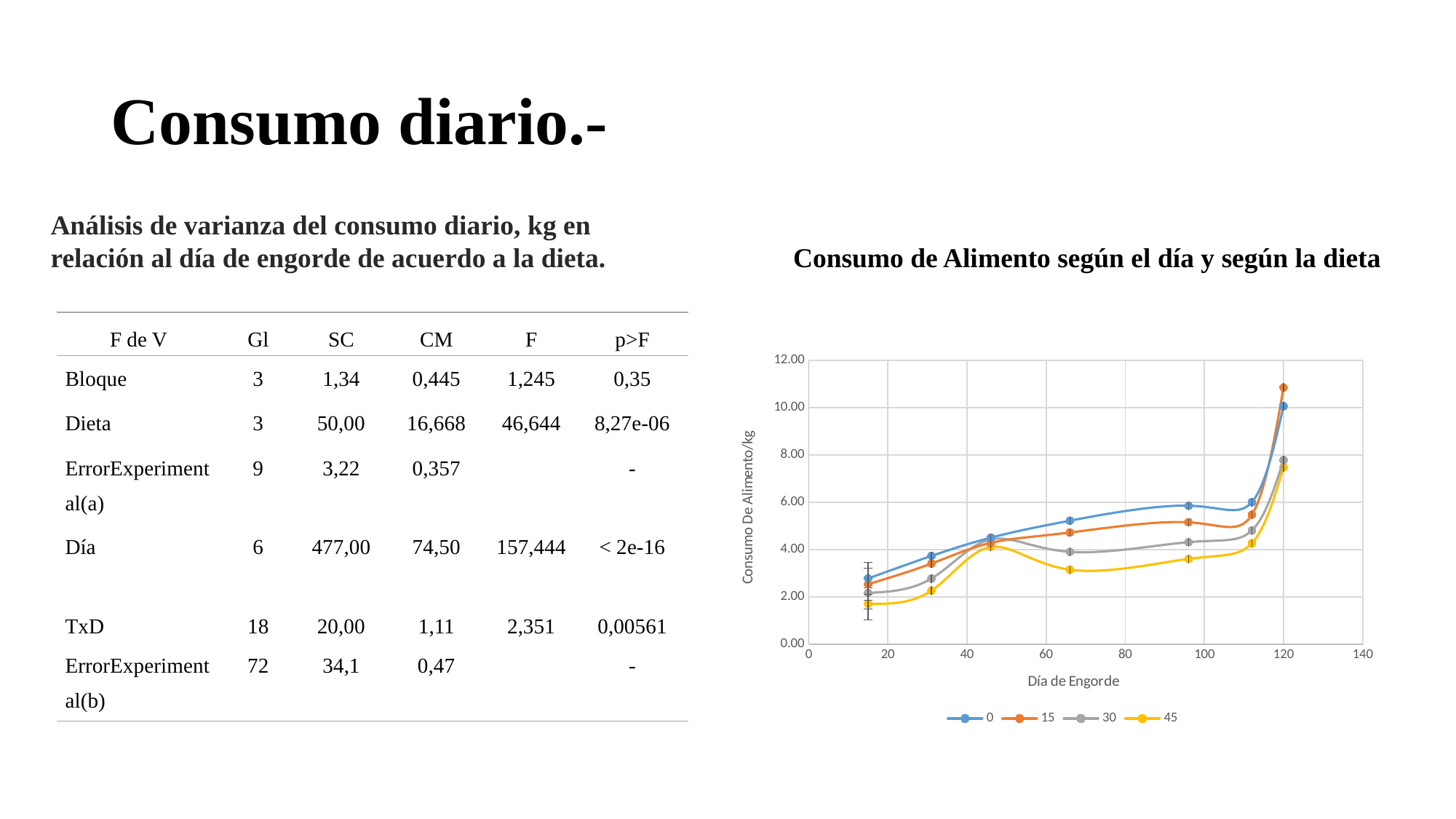
What kind of chart is shown on the slide? line chart What are the series names listed in the chart legend? 0, 15, 30, 45 Is the value for series 45 at around day 66 greater or less than 4.00? less What is the title of the chart? Consumo de Alimento según el día y según la dieta How many data points are plotted for each series in the chart? 7 Is the value for series 15 at day 120 greater or less than 10.00? greater Which series has the lowest value at the first point (around day 15)? 45 Does the value for series 0 rise or fall from the first day to day 120? rise Which series has the highest value at day 120? 15 Is the value for series 0 at around day 66 greater or less than 4.00? greater How many series does the legend of the chart list? 4